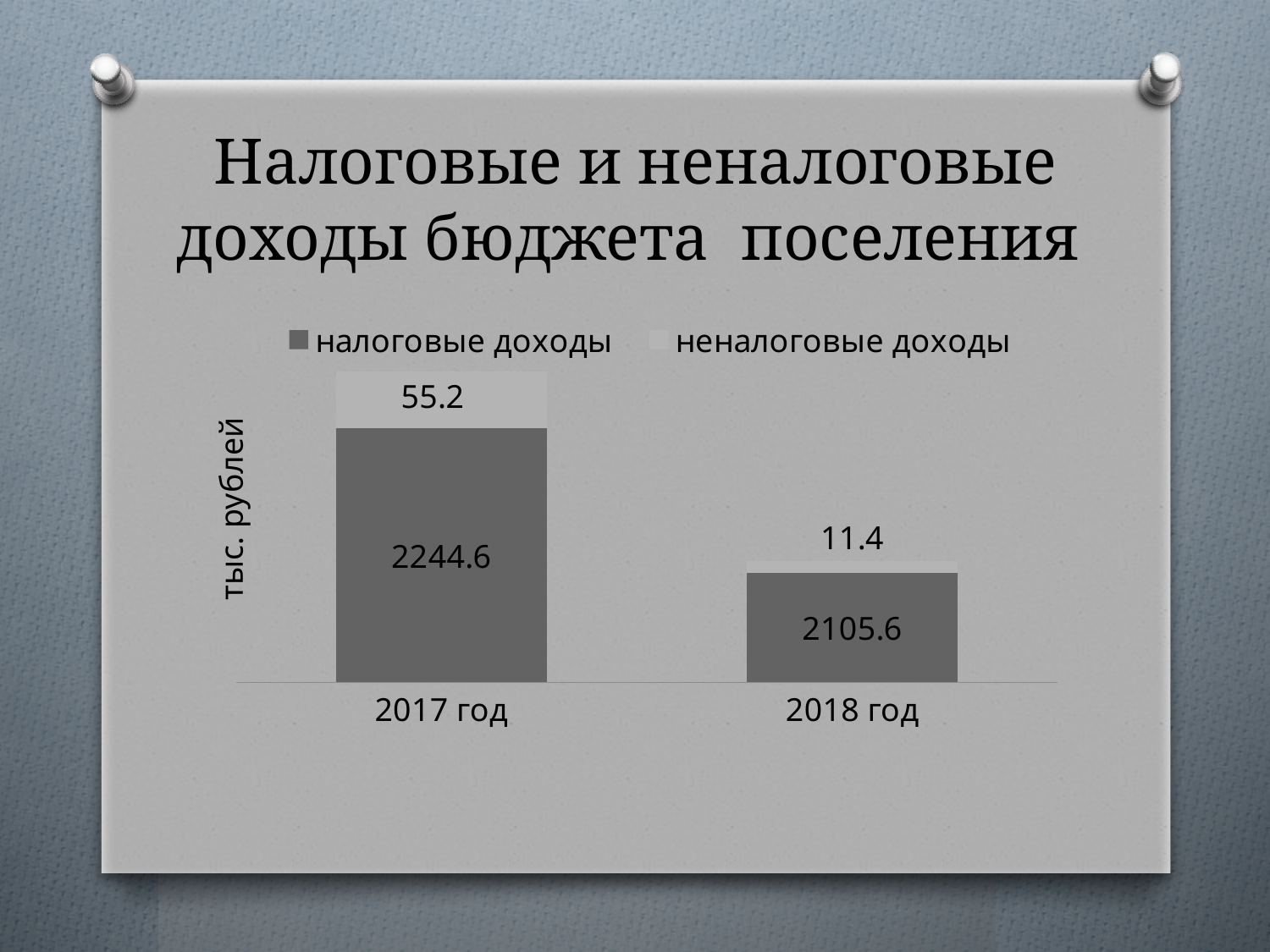
How many series does the legend list? 2 What is the total of the stacked bar for 2017 год? 2299.8 What is the difference between неналоговые доходы in 2017 год and 2018 год? 43.8 What is the value of налоговые доходы for 2018 год? 2105.6 Which year has the higher value of налоговые доходы? 2017 год What is the value of неналоговые доходы for 2018 год? 11.4 What kind of chart is shown on the slide? Stacked bar chart Which year has the lower value of неналоговые доходы? 2018 год What is the difference between налоговые доходы in 2017 год and 2018 год? 139.0 What is the value of налоговые доходы for 2017 год? 2244.6 What is the total of the stacked bar for 2018 год? 2117.0 What is the value of неналоговые доходы for 2017 год? 55.2